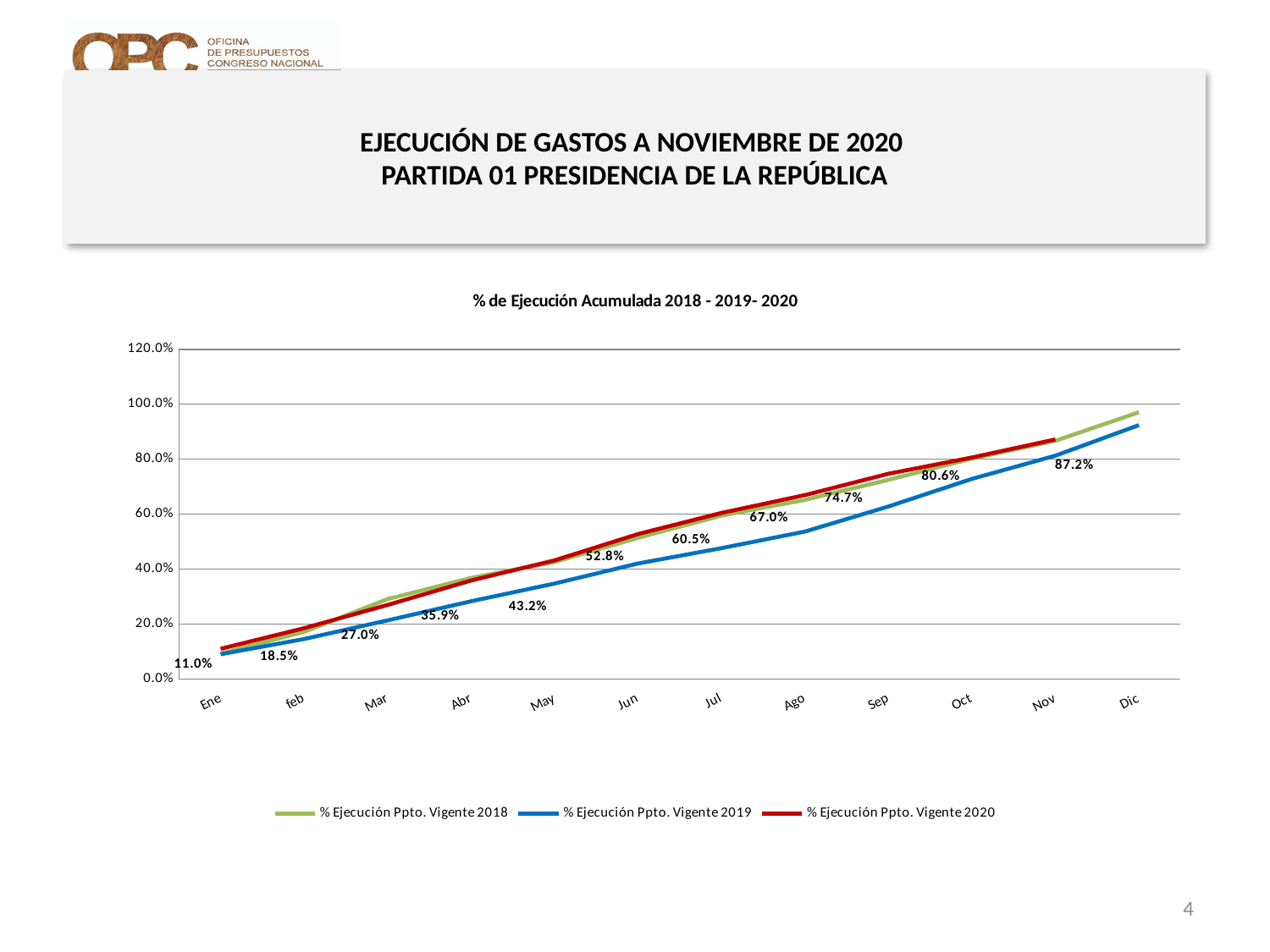
Is the value for % Ejecución Ppto. Vigente 2019 in Ago greater or less than 60.0%? less In Nov, which series has the larger value: % Ejecución Ppto. Vigente 2020 or % Ejecución Ppto. Vigente 2019? % Ejecución Ppto. Vigente 2020 What is the value for % Ejecución Ppto. Vigente 2020 in Jun? 52.8% Is the value for % Ejecución Ppto. Vigente 2019 in Dic greater or less than 80.0%? greater What is the value for % Ejecución Ppto. Vigente 2020 in Nov? 87.2% What is the title of the chart? % de Ejecución Acumulada 2018 - 2019- 2020 Do the values of the series rise or fall from Ene to Nov? rise How many months are shown along the x axis? 12 How many series does the legend list? 3 What is the value for % Ejecución Ppto. Vigente 2020 in Ene? 11.0% What kind of chart is shown on the slide? line chart What is the difference between the 2020 values for Nov and Oct? 6.6%